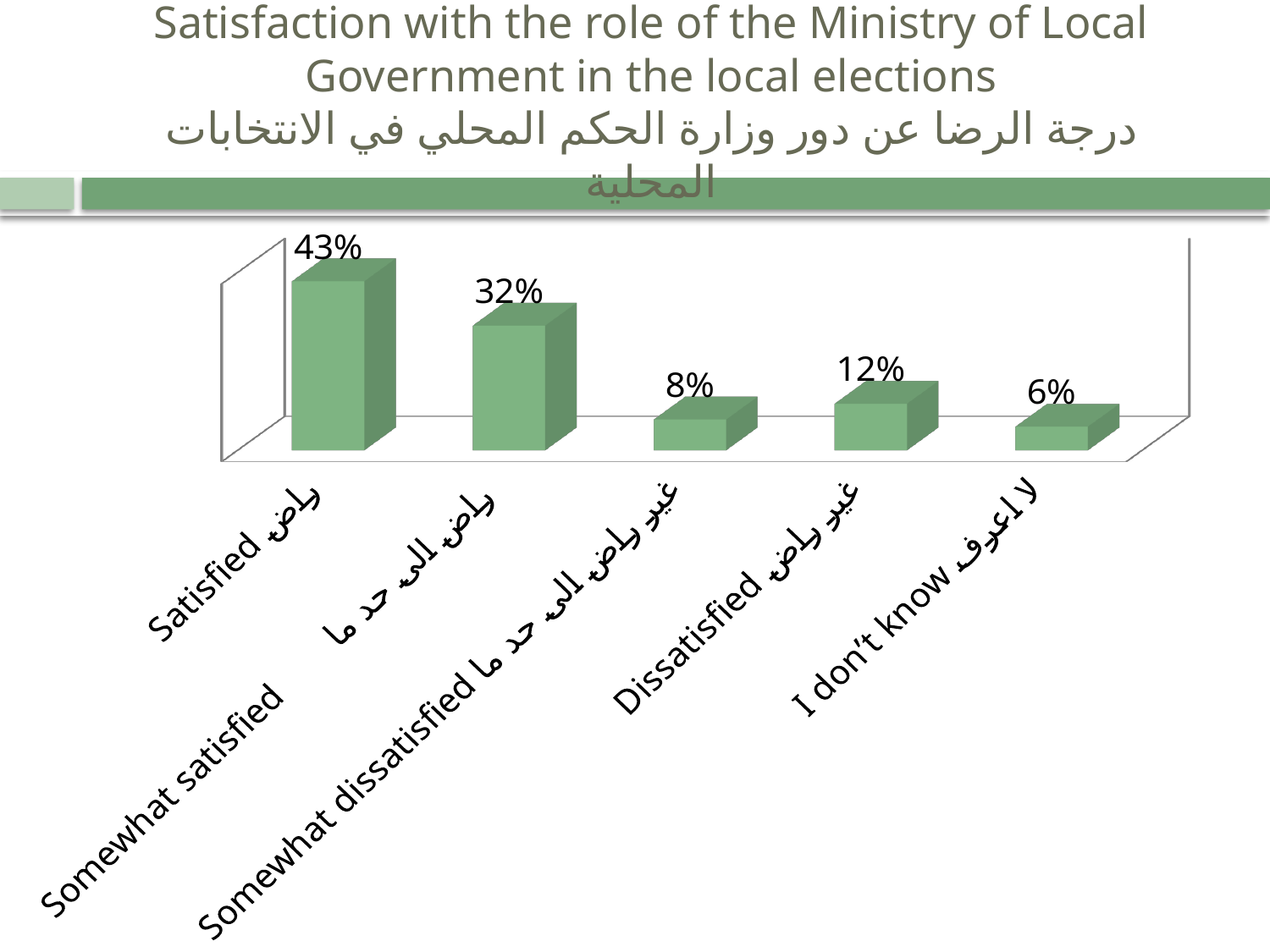
Which category has the lowest value? I don't know What is the value shown for I don't know? 6% Which category has the highest value? Satisfied What kind of chart is shown on the slide? Bar chart What is the combined value of Satisfied and Somewhat satisfied? 75% What is the value shown for Somewhat satisfied? 32% What is the difference between the Satisfied and Somewhat satisfied values? 11% What is the value shown for Dissatisfied? 12% Which is larger, the value for Dissatisfied or the value for Somewhat dissatisfied? Dissatisfied What is the value shown for Somewhat dissatisfied? 8% How many categories are shown in the chart? 5 What percentage of respondents are Satisfied with the role of the Ministry of Local Government in the local elections? 43%